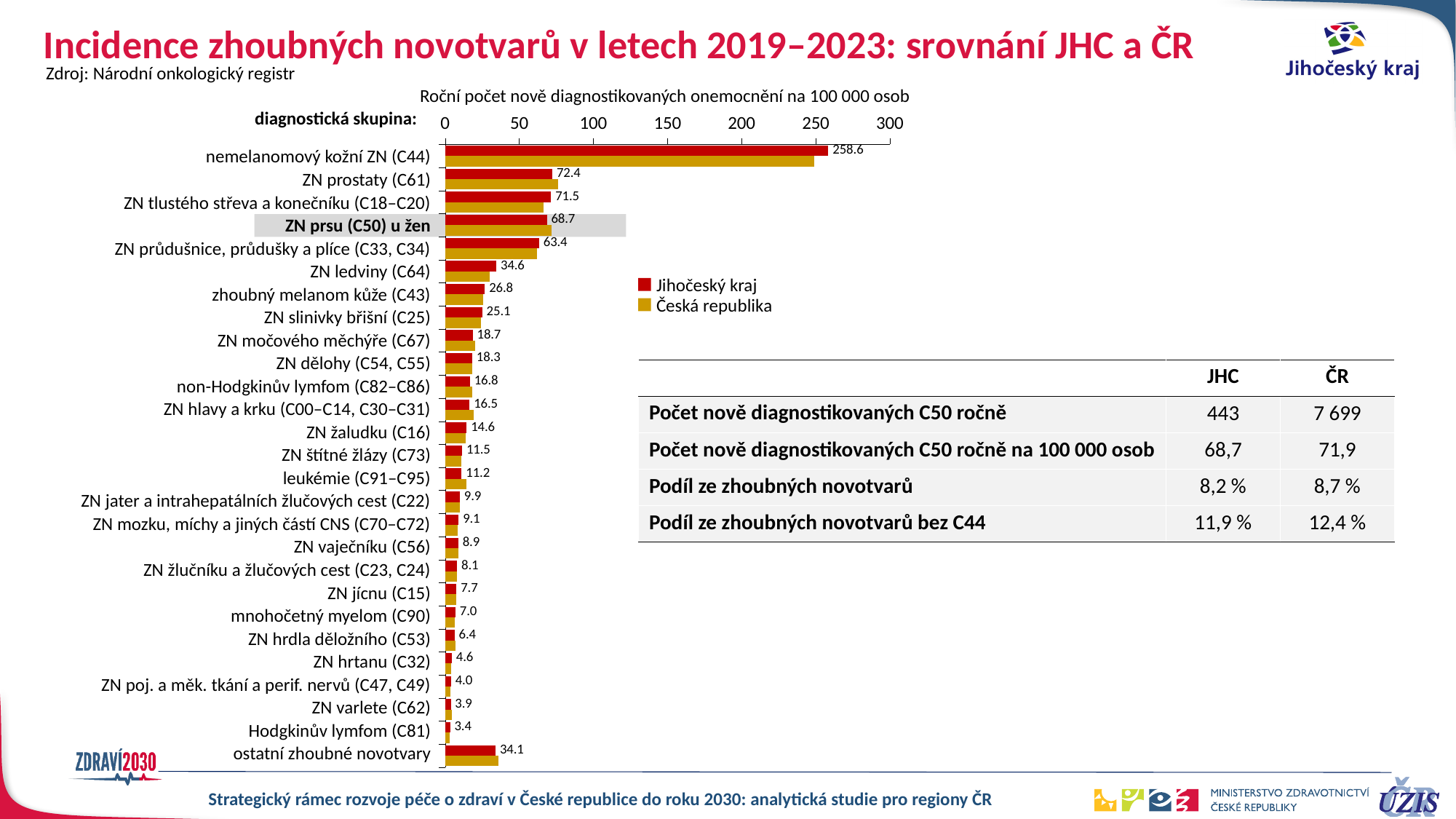
What kind of chart is shown on the slide? bar chart How many diagnostic groups are shown on the chart? 27 Is the Česká republika value for nemelanomový kožní ZN (C44) greater or less than 200? greater What is the value for Jihočeský kraj for ZN ledviny (C64)? 34.6 Which diagnostic group has the lowest labelled value for Jihočeský kraj? Hodgkinův lymfom (C81) What is the value for Jihočeský kraj for ZN prsu (C50) u žen? 68.7 What is the difference between the Jihočeský kraj values for ZN prostaty (C61) and ZN tlustého střeva a konečníku (C18–C20)? 0.9 What is the value for Jihočeský kraj for nemelanomový kožní ZN (C44)? 258.6 Which diagnostic group has the highest value for Jihočeský kraj? nemelanomový kožní ZN (C44) Is the Česká republika value for ZN prostaty (C61) greater or less than 100? less How many series does the legend list? 2 Which has a larger Jihočeský kraj value: ZN ledviny (C64) or zhoubný melanom kůže (C43)? ZN ledviny (C64)